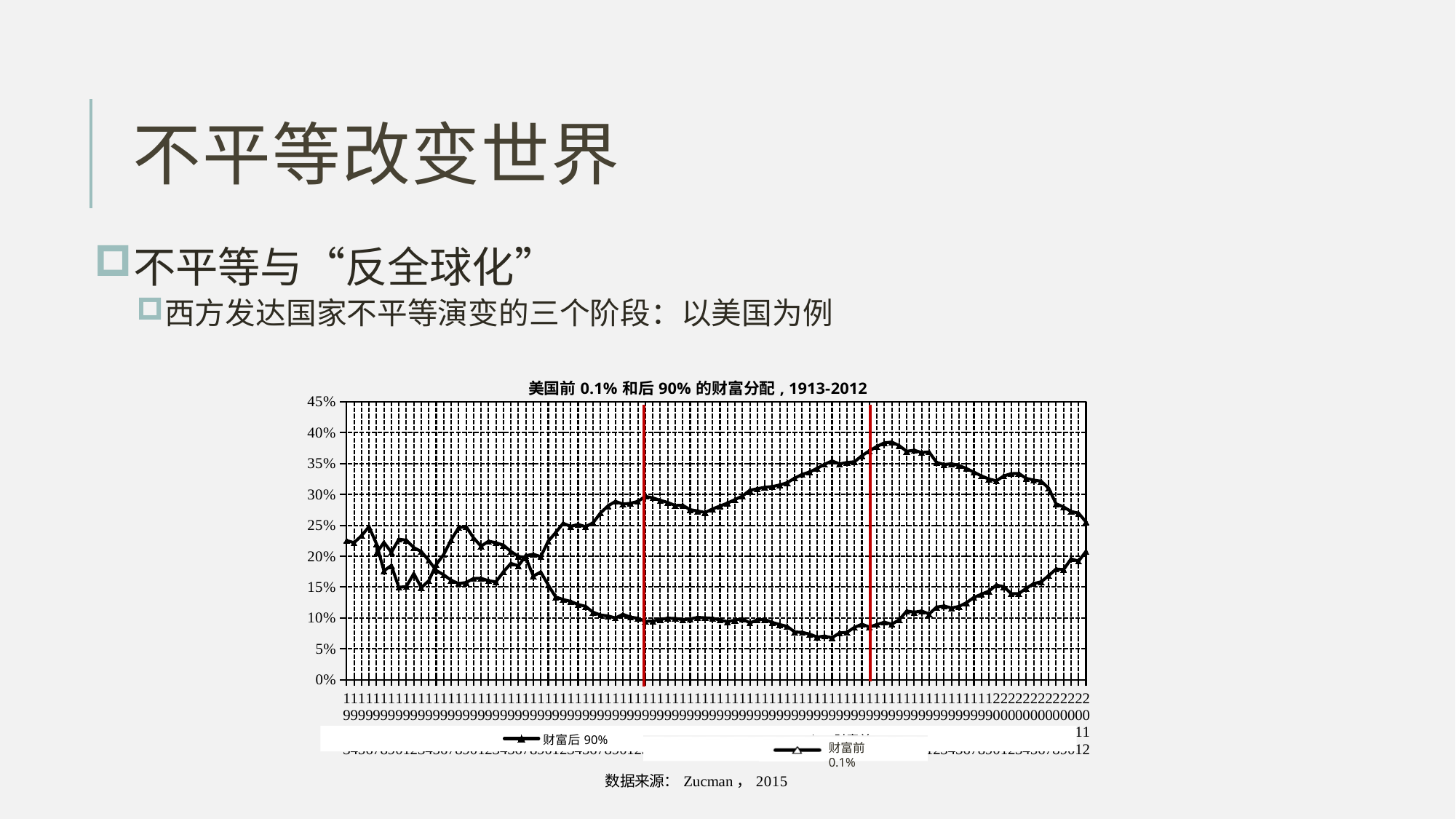
What kind of chart is shown on the slide? line chart What is the title of the chart? 美国前 0.1% 和后 90% 的财富分配，1913-2012 Is the highest value reached by the 财富前 0.1% series greater or less than 30%? less Does the 财富前 0.1% series rise or fall over the final portion of the chart, after the second red vertical line? rise Which series reaches the higher peak on the chart, 财富后 90% or 财富前 0.1%? 财富后 90% Is the highest value reached by the 财富后 90% series greater or less than 35%? greater Which series reaches the lowest value anywhere on the chart? 财富前 0.1% What are the two series named in the chart's legend? 财富后 90% and 财富前 0.1% How many series does the chart's legend list? 2 What is the highest value shown on the chart's y axis? 45% Is the lowest value reached by the 财富前 0.1% series greater or less than 10%? less Does the 财富后 90% series rise or fall from its peak to the right-hand end of the chart? fall